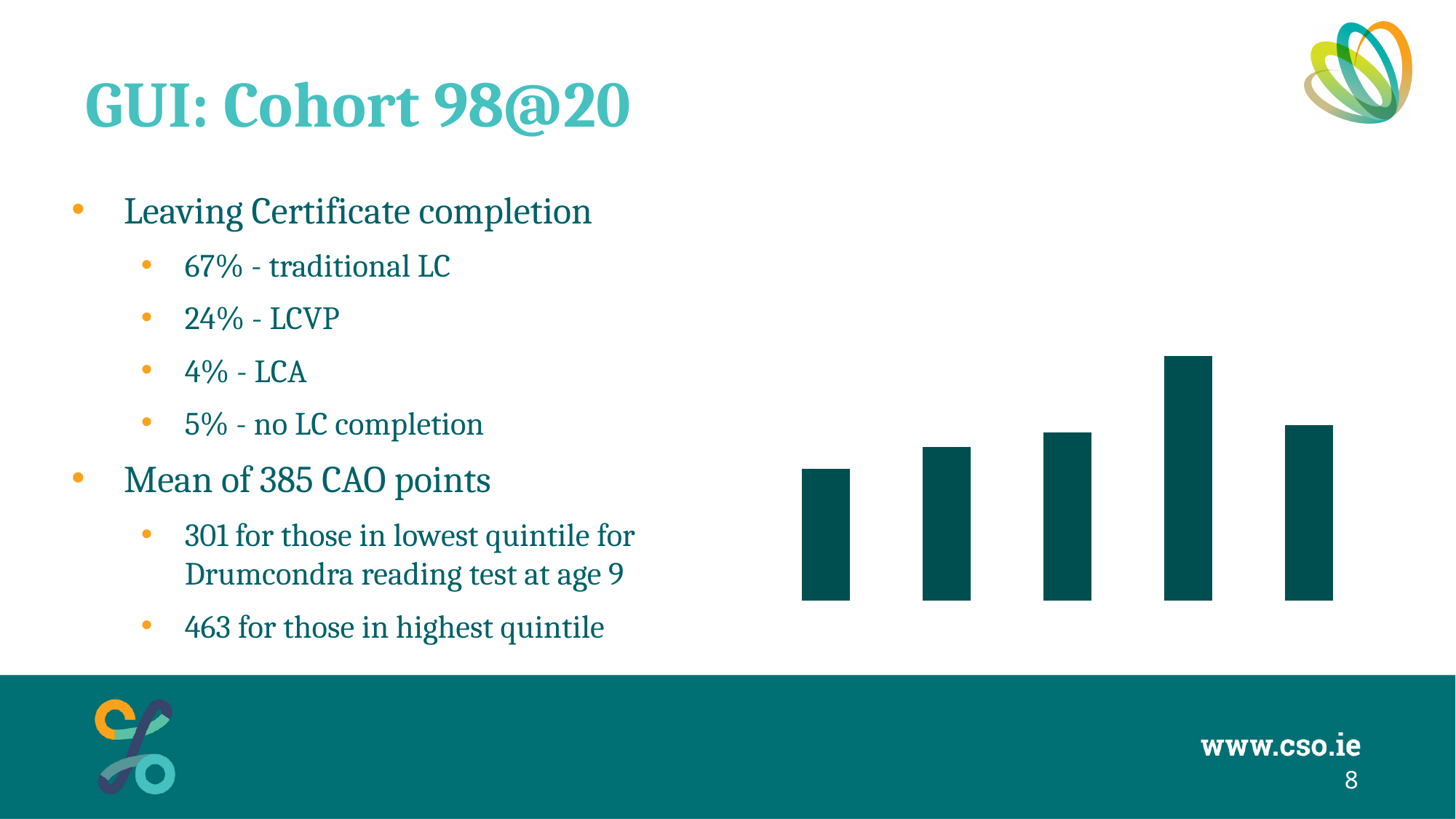
How many bars does the chart on the right of the slide have? 5 Do the bars in the chart rise or fall from the first bar to the fourth bar? rise In the chart, is the first bar or the fourth bar taller? the fourth bar Does the chart on the slide show a legend? No What kind of chart is shown on the right of the slide? bar chart What colour are the bars in the chart? dark teal In the chart, is the fourth bar or the fifth bar taller? the fourth bar Which bar in the chart is the shortest, counting from the left? the first bar Which bar in the chart is the tallest, counting from the left? the fourth bar In the chart, is the first bar or the second bar taller? the second bar